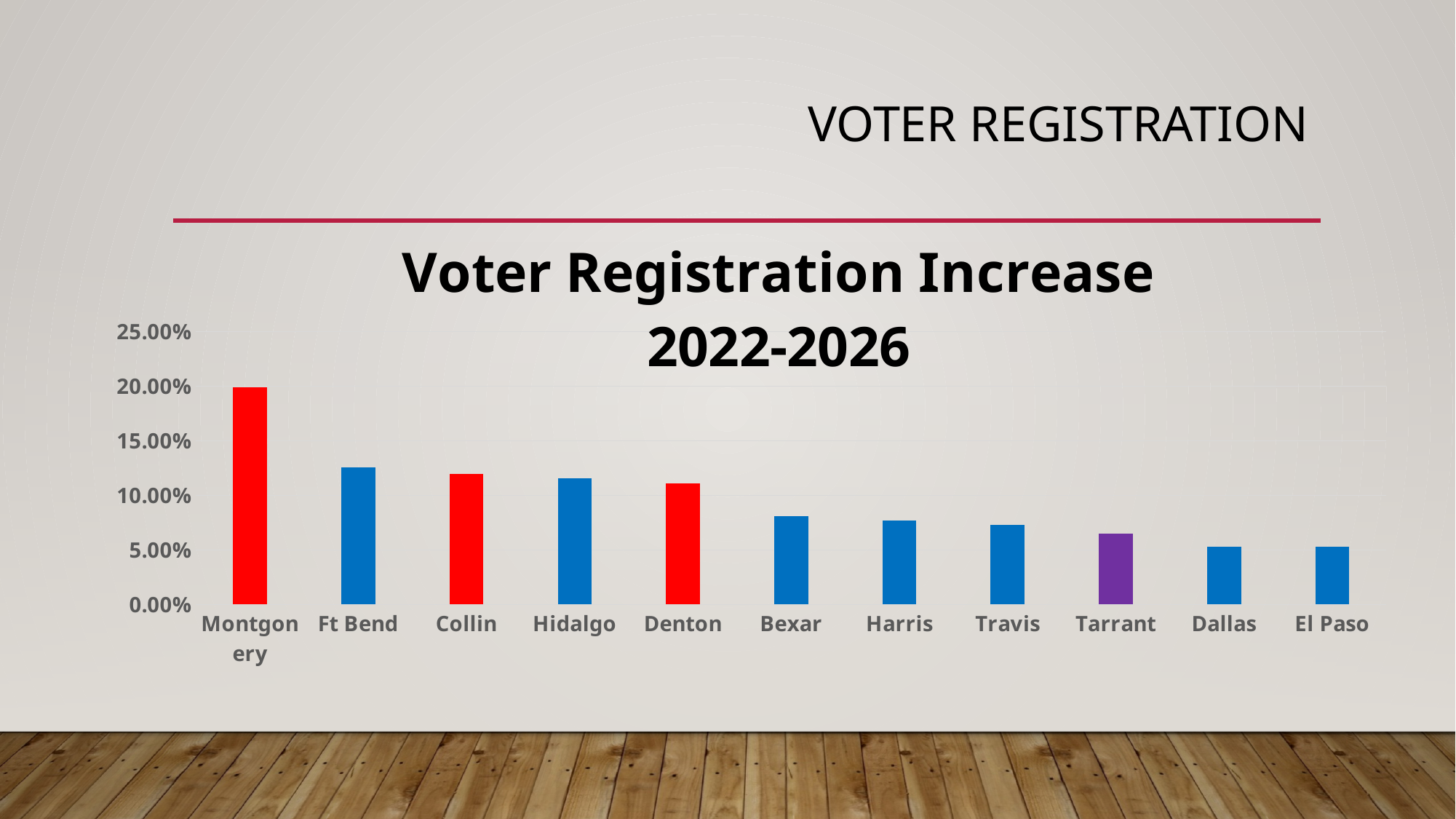
Is the value for Harris greater or less than 10.00%? less Do the bar values rise or fall moving from left to right across the chart? fall How many counties are plotted in the Voter Registration Increase 2022-2026 chart? 11 What colour is the bar for Tarrant? purple What kind of chart is shown on the slide? bar chart Is the value for Tarrant greater or less than 5.00%? greater Which county has the highest voter registration increase in the chart? Montgonery Is the value for Montgomery greater or less than 15.00%? greater Which has a larger voter registration increase, Ft Bend or Bexar? Ft Bend Which has a larger voter registration increase, Hidalgo or Travis? Hidalgo